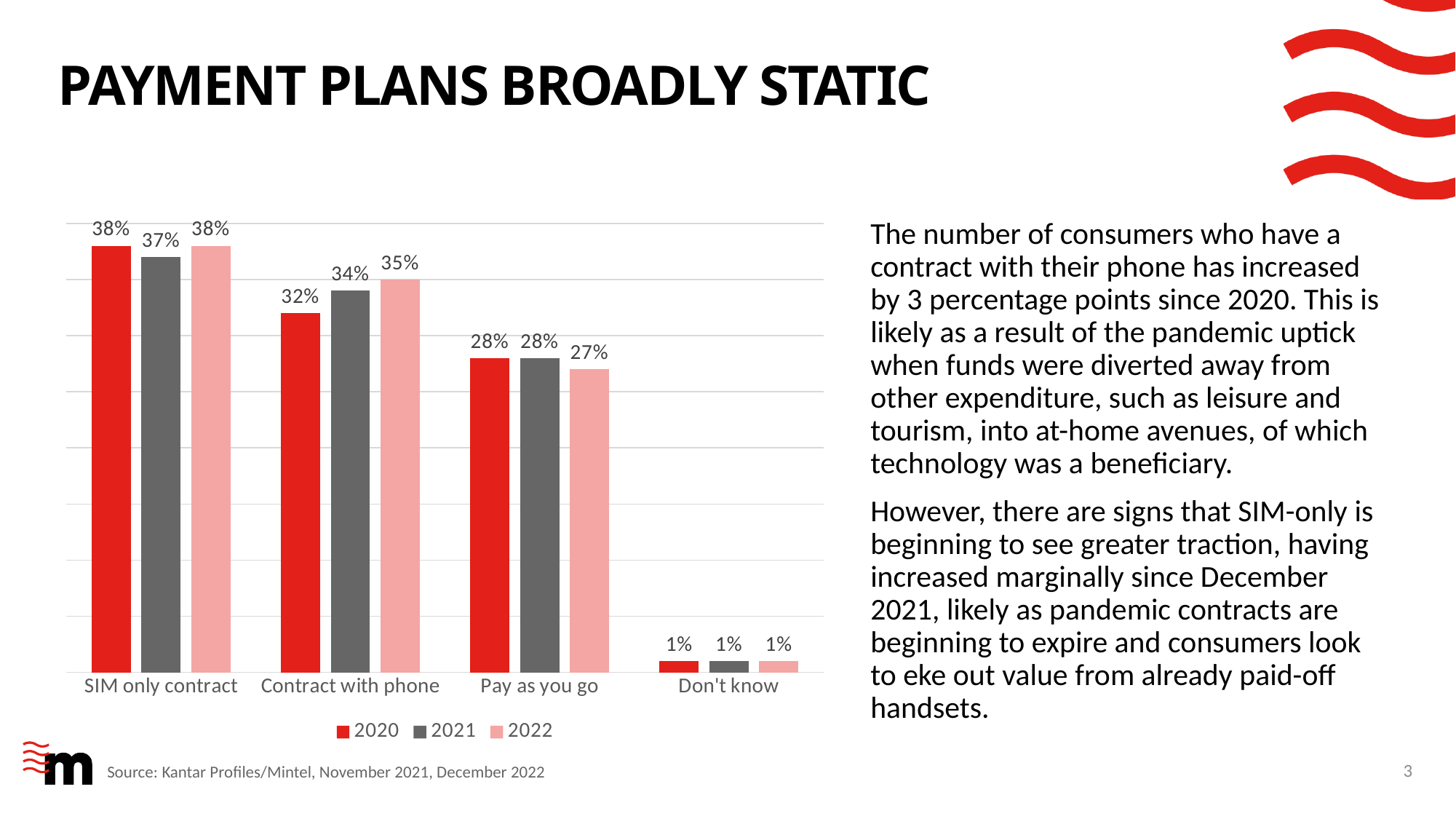
Which category has the highest value in 2022? SIM only contract What kind of chart is shown on the slide? Bar chart What is the value for SIM only contract in 2020? 38% What is the difference between the 2022 and 2020 values for Contract with phone? 3% Do the values for Contract with phone rise or fall from 2020 to 2022? Rise Which is larger for Pay as you go: the 2020 value or the 2022 value? 2020 How many categories are shown on the x axis? 4 Which category has the lowest value in 2021? Don't know What is the value for Don't know in 2022? 1% What is the value for Pay as you go in 2021? 28% What is the value for Contract with phone in 2022? 35% How many series does the legend list? 3